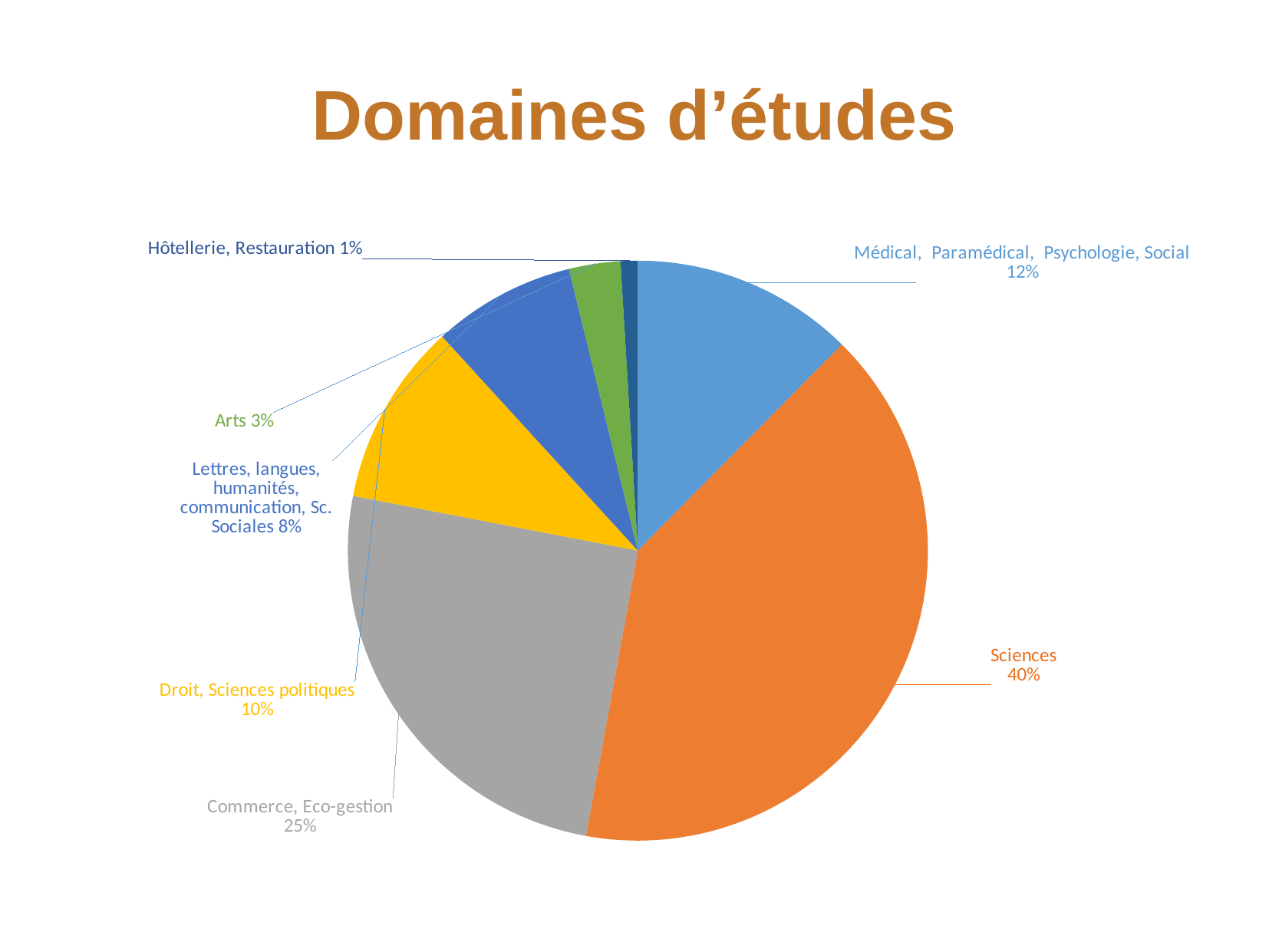
What share of the pie does Sciences represent? 40% What percentage is shown for Droit, Sciences politiques? 10% Which is larger: Droit, Sciences politiques or Lettres, langues, humanités, communication, Sc. Sociales? Droit, Sciences politiques What is the title of the chart? Domaines d’études What percentage is shown for Médical, Paramédical, Psychologie, Social? 12% What percentage is shown for Commerce, Eco-gestion? 25% What percentage is shown for Arts? 3% What kind of chart is shown on the slide? pie chart How many slices does the pie chart have? 7 Which category has the smallest slice of the pie? Hôtellerie, Restauration What is the difference in percentage points between Sciences and Commerce, Eco-gestion? 15% Which category has the largest slice of the pie? Sciences